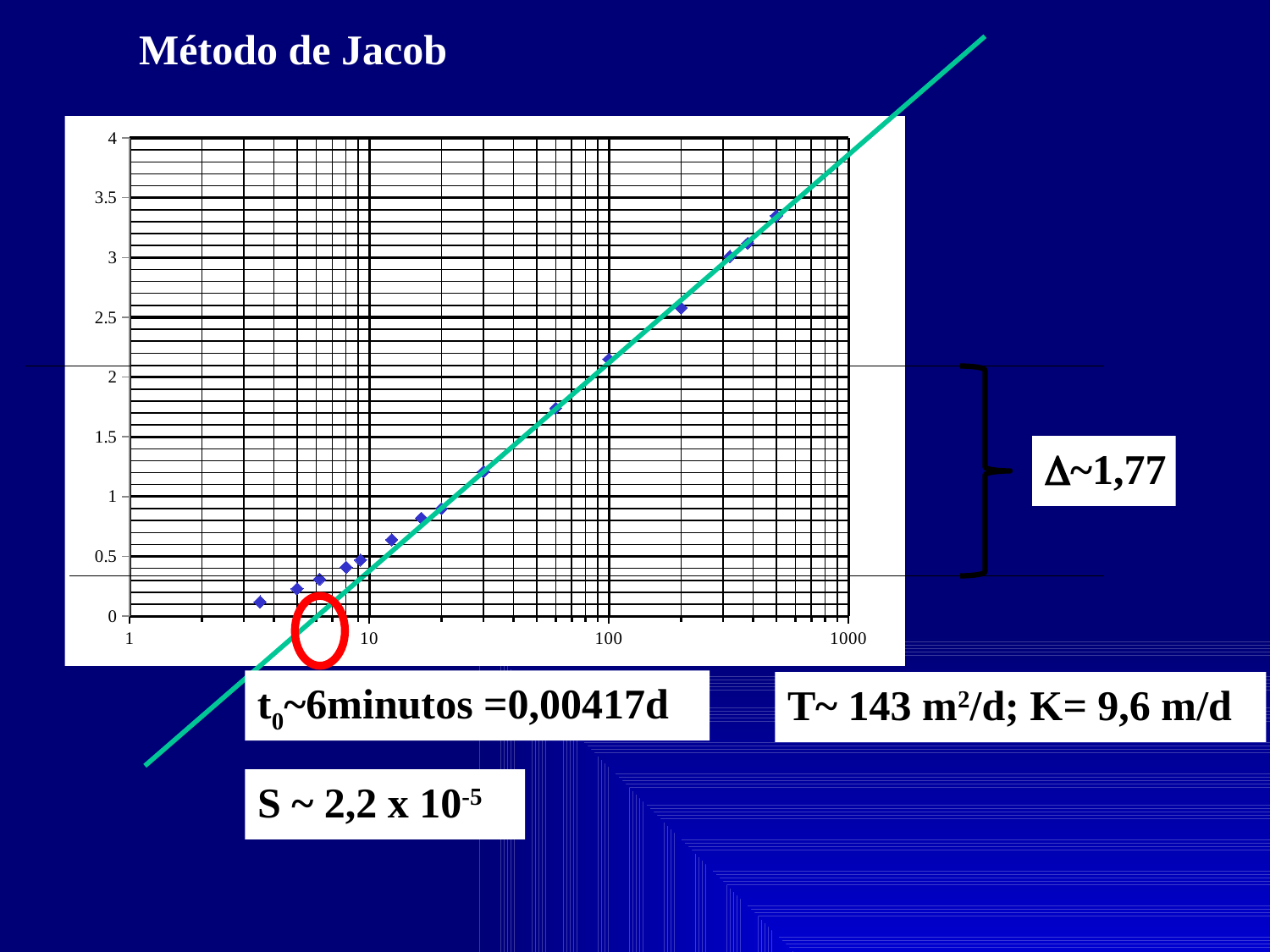
What value of Δ is annotated next to the chart? Δ~1,77 Is the value of the rightmost plotted point greater or less than 3? greater Which has the larger value, the point at x = 100 or the point at x = 10? the point at x = 100 Is the value of the point at about x = 60 greater or less than 2? less What kind of chart is shown on the slide? scatter chart Is the value of the point at x = 100 greater or less than 1.5? greater Do the plotted values rise or fall as the x axis increases? rise What is the highest tick value shown on the y axis? 4 What is the highest tick value shown on the x axis? 1000 What value of t0 is annotated below the chart? t0~6minutos =0,00417d